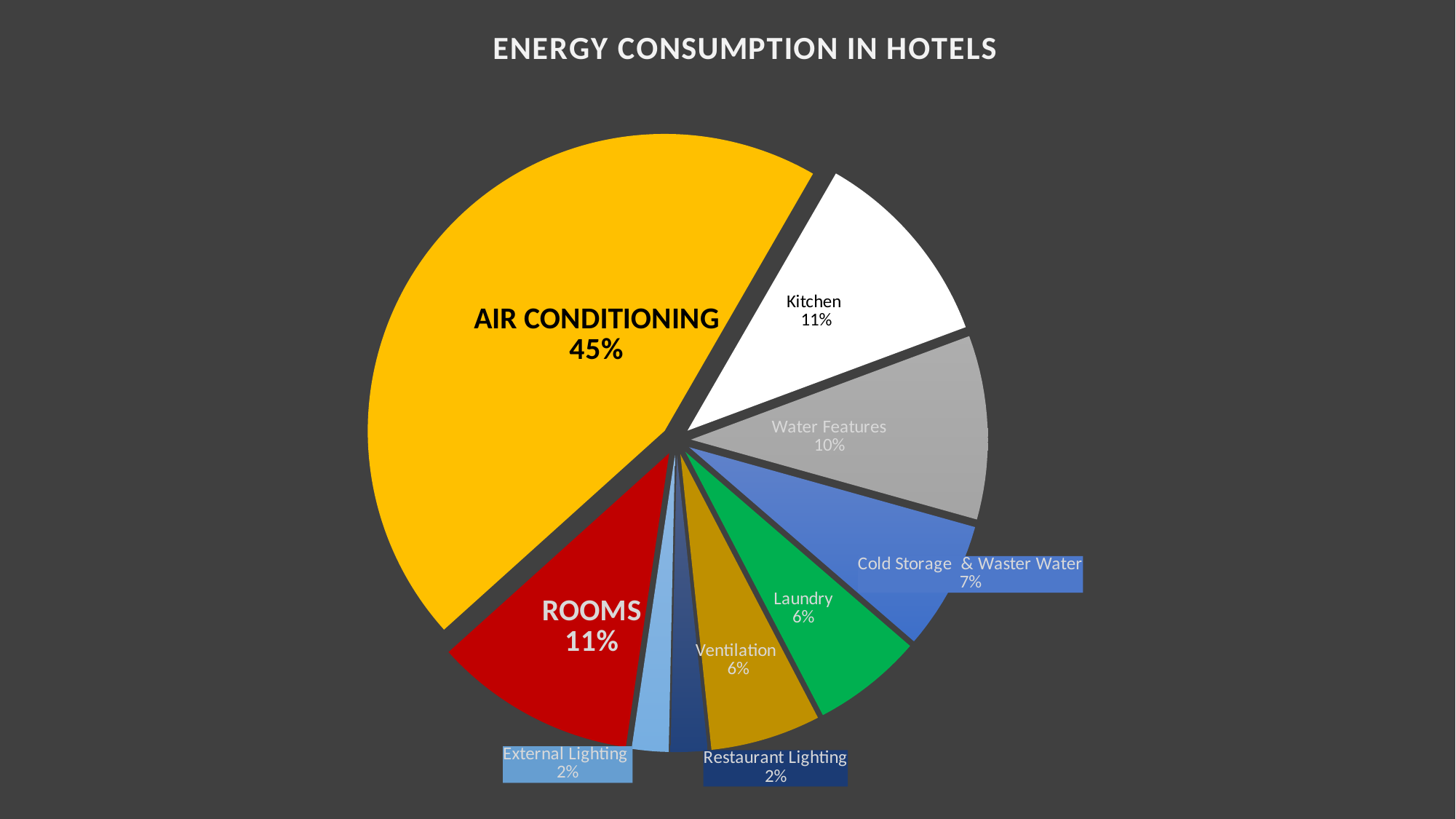
What percentage is shown for Cold Storage & Waster Water? 7% What is the title of the chart? ENERGY CONSUMPTION IN HOTELS What is the value shown for Water Features? 10% Which is larger, the share for Water Features or the share for Laundry? Water Features What share of energy consumption is attributed to Air Conditioning? 45% How many slices does the pie chart have? 9 What type of chart is shown on the slide? Pie chart What percentage does the Kitchen slice represent? 11% What colour is the Air Conditioning slice? Yellow What is the combined share of Laundry and Ventilation? 12% Which category has the largest share of energy consumption? Air Conditioning What is the difference in percentage points between Air Conditioning and Rooms? 34